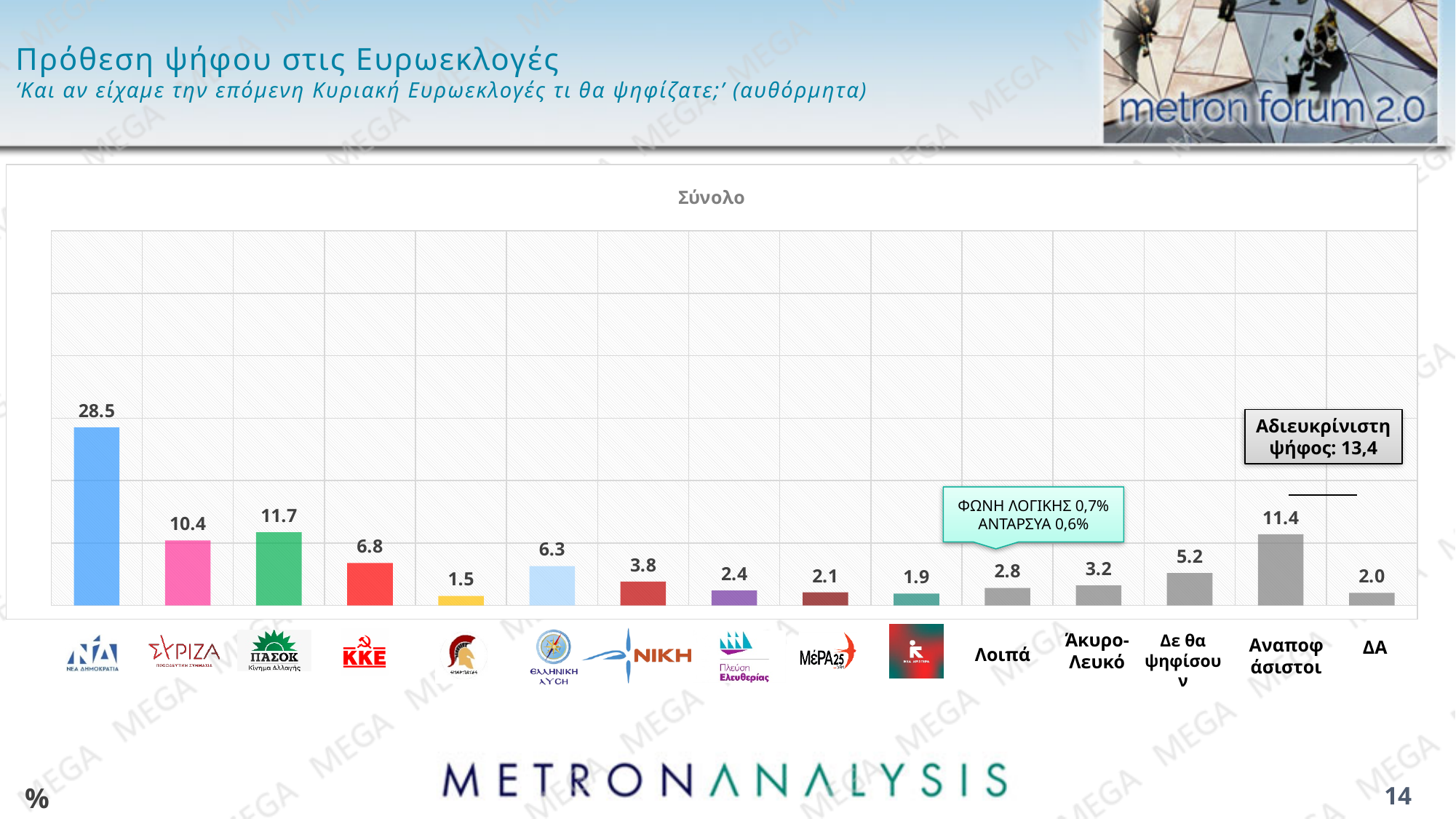
What value is given for Αδιευκρίνιστη ψήφος in the box on the chart? 13,4 What kind of chart is shown on the slide? bar chart What is the value for ΚΚΕ? 6.8 What is the value for ΠΑΣΟΚ? 11.7 Which is larger, the value for ΝΙΚΗ or the value for Δε θα ψηφίσουν? Δε θα ψηφίσουν Which category has the highest value? ΝΕΑ ΔΗΜΟΚΡΑΤΙΑ What is the title of the chart? Σύνολο Which is larger, the value for ΚΚΕ or the value for ΕΛΛΗΝΙΚΗ ΛΥΣΗ? ΚΚΕ What is the difference between the values for ΠΑΣΟΚ and ΣΥΡΙΖΑ? 1.3 What is the value for Αναποφάσιστοι? 11.4 How many bars are plotted in the chart? 15 What is the value for ΝΕΑ ΔΗΜΟΚΡΑΤΙΑ? 28.5